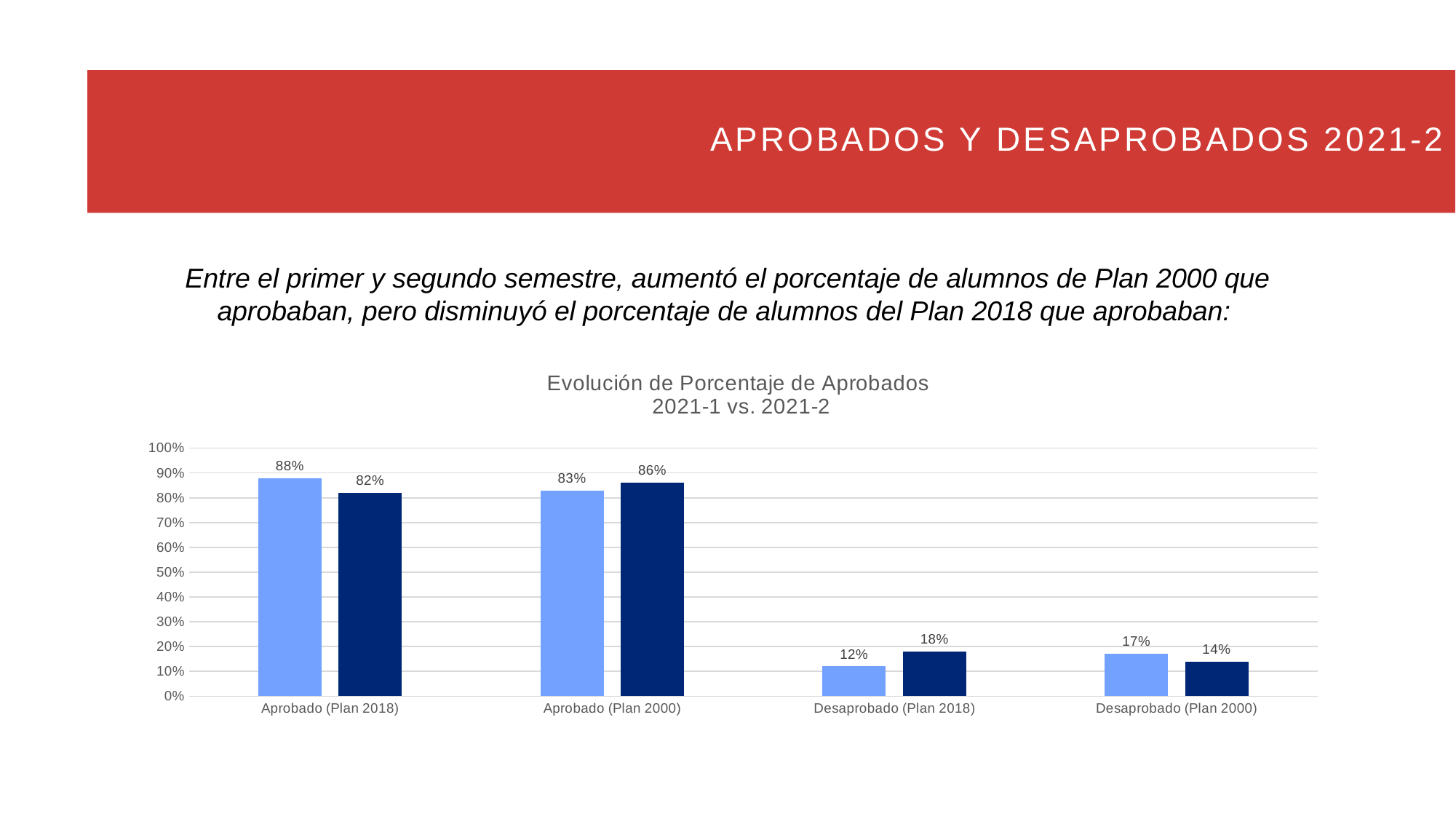
What is the value of the dark blue bar for Aprobado (Plan 2000)? 86% What is the value of the light blue bar for Desaprobado (Plan 2000)? 17% What is the difference between the light blue and dark blue bars for Aprobado (Plan 2018)? 6% Which category has the highest light blue bar? Aprobado (Plan 2018) What is the value of the dark blue bar for Desaprobado (Plan 2018)? 18% What kind of chart is shown on the slide? bar chart What is the value of the light blue bar for Aprobado (Plan 2018)? 88% How many categories are shown on the x axis? 4 What is the title of the chart? Evolución de Porcentaje de Aprobados 2021-1 vs. 2021-2 Which category has the lowest light blue bar? Desaprobado (Plan 2018) For Desaprobado (Plan 2000), which bar is larger, the light blue or the dark blue? light blue Is the dark blue bar for Aprobado (Plan 2018) greater or less than 90%? less